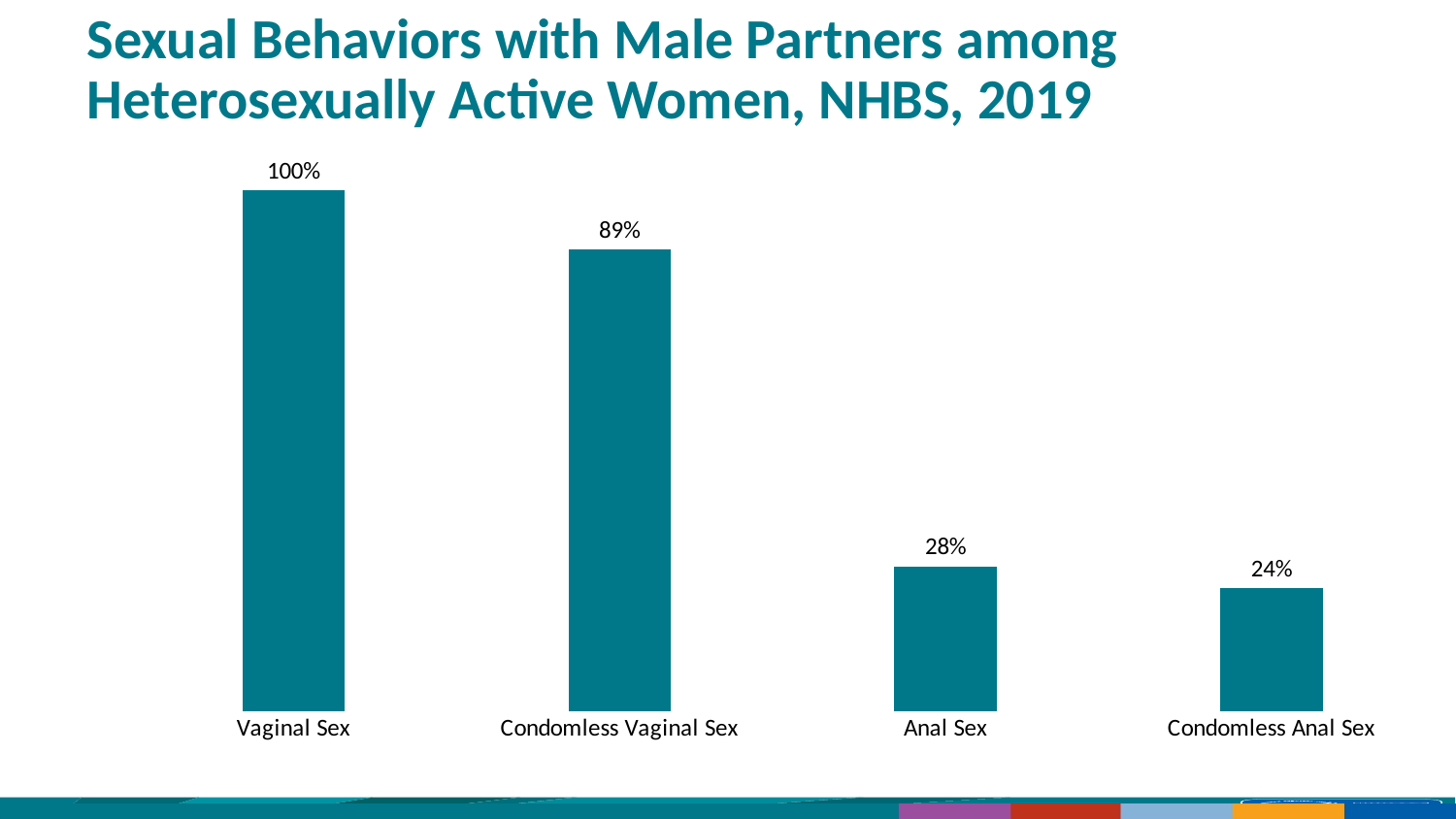
What kind of chart is shown on the slide? Bar chart Which category has the lowest value? Condomless Anal Sex What percentage is shown for Anal Sex? 28% What is the difference between the values for Anal Sex and Condomless Anal Sex? 4% What is the title of the chart? Sexual Behaviors with Male Partners among Heterosexually Active Women, NHBS, 2019 Which category has the highest value? Vaginal Sex How many categories are shown in the chart? 4 Which is larger, the value for Condomless Vaginal Sex or the value for Anal Sex? Condomless Vaginal Sex What is the difference between the values for Vaginal Sex and Condomless Vaginal Sex? 11% What percentage is shown for Condomless Vaginal Sex? 89% What percentage is shown for Condomless Anal Sex? 24% What percentage is shown for Vaginal Sex? 100%